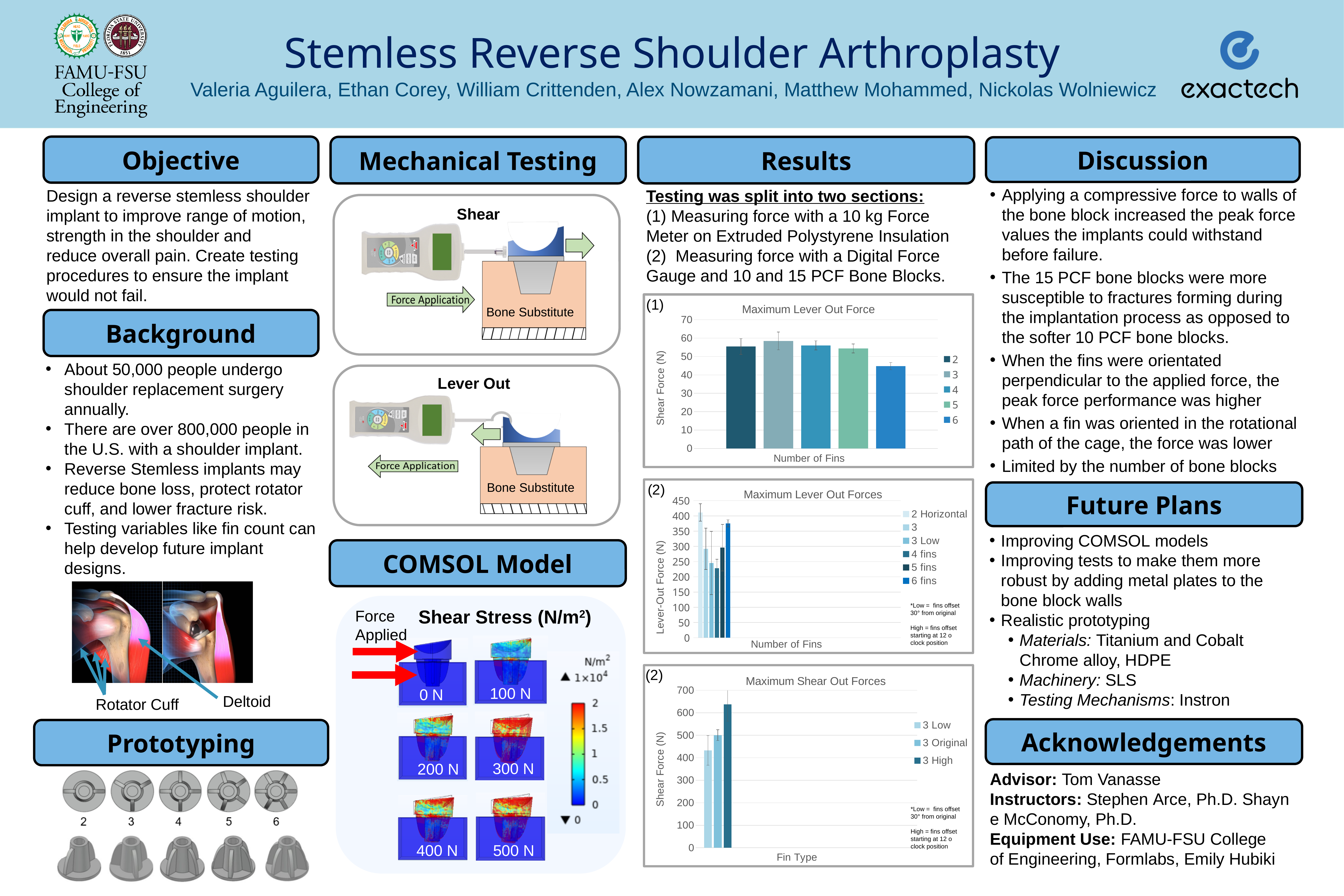
In the 'Maximum Lever Out Forces' chart, which series has the highest lever-out force? 2 Horizontal In the 'Maximum Shear Out Forces' chart, which fin type has the highest shear force? 3 High In the 'Maximum Lever Out Force' chart, which number of fins has the lowest shear force? 6 In the 'Maximum Lever Out Force' chart, is the value for 3 fins greater or less than 50? greater In the 'Maximum Shear Out Forces' chart, is the value for 3 High greater or less than 600? greater In the 'Maximum Lever Out Forces' chart, is the value for 2 Horizontal greater or less than 350? greater How many series does the legend of the 'Maximum Lever Out Force' chart list? 5 What is the y-axis label of the 'Maximum Lever Out Force' chart? Shear Force (N) How many series does the legend of the 'Maximum Lever Out Forces' chart list? 6 What kind of chart is the 'Maximum Lever Out Force' chart? bar chart In the 'Maximum Lever Out Force' chart, which is larger: the value for 3 fins or the value for 6 fins? 3 fins